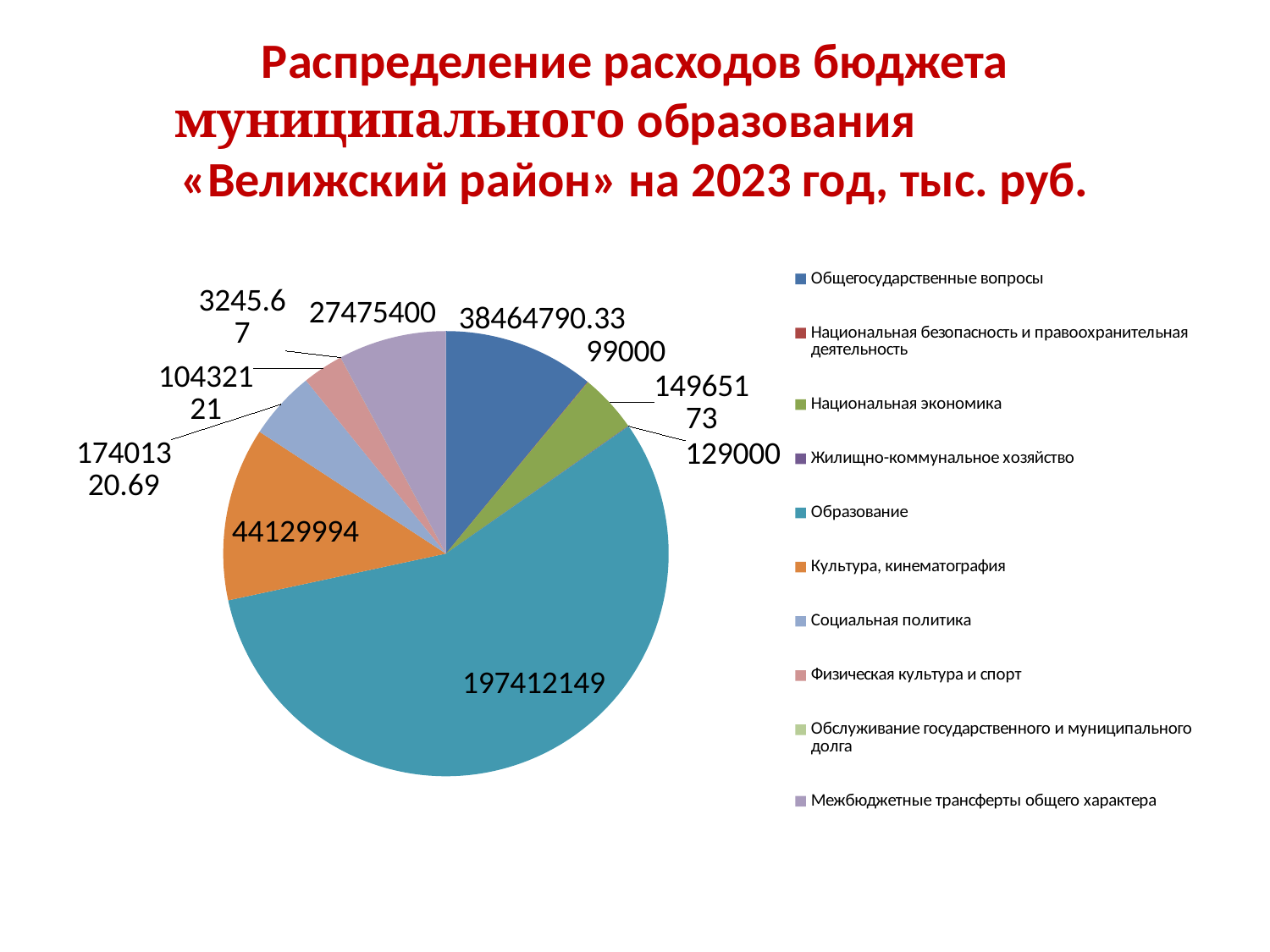
What is the value shown for Межбюджетные трансферты общего характера? 27475400 Which category has the largest slice of the pie chart? Образование What is the difference between the values for Образование and Культура, кинематография? 153282155 Which is larger, the value for Образование or the value for Культура, кинематография? Образование Which is larger, the value for Культура, кинематография or the value for Общегосударственные вопросы? Культура, кинематография What is the value shown for Общегосударственные вопросы? 38464790.33 What is the value shown for Образование? 197412149 How many categories does the legend of the pie chart list? 10 What kind of chart is shown on the slide? pie chart For which year does the chart title say the budget expenditure distribution is shown? 2023 What is the difference between the values for Культура, кинематография and Общегосударственные вопросы? 5665203.67 What is the value shown for Культура, кинематография? 44129994